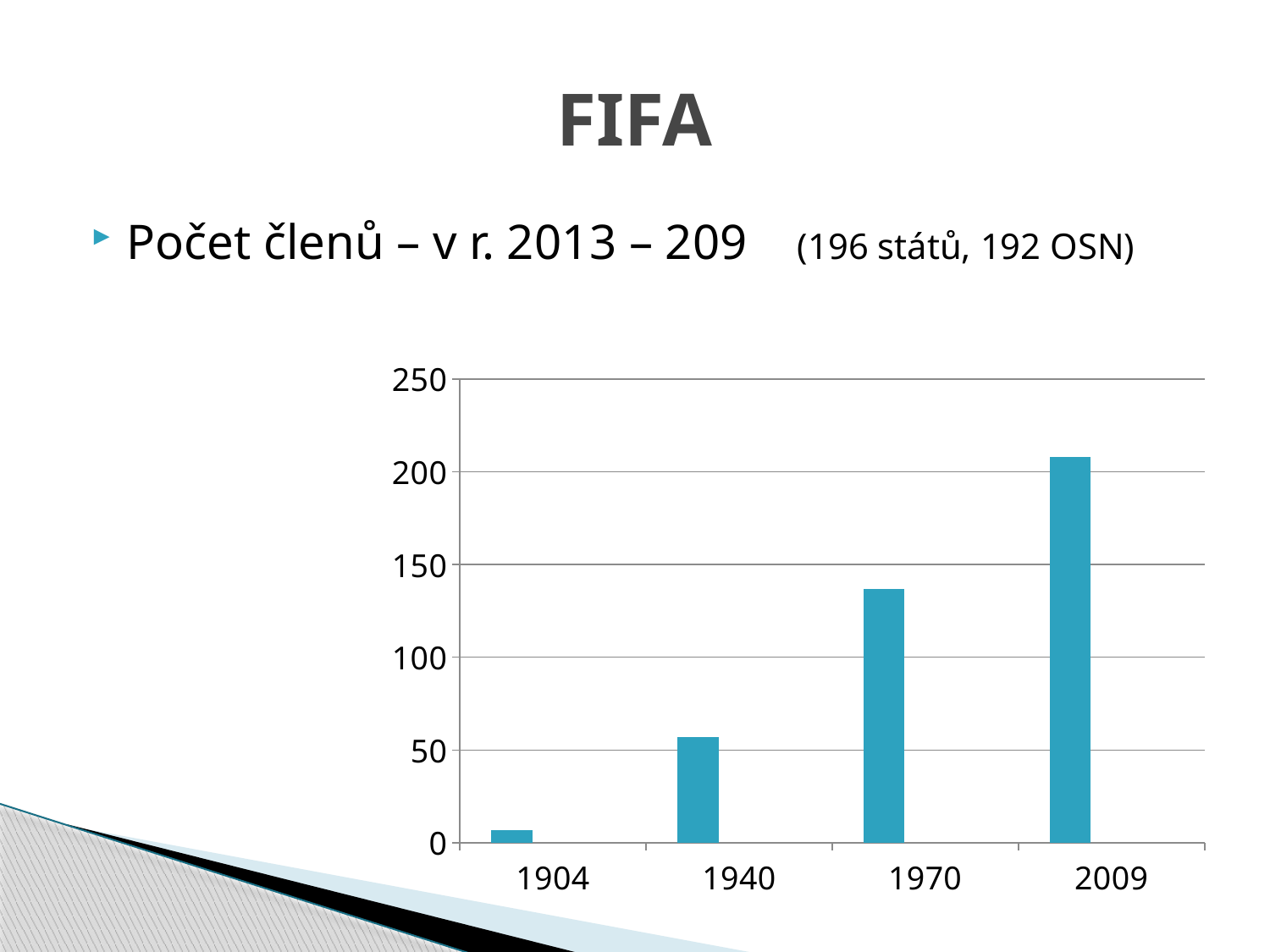
Is the value for 1970 greater or less than 150? less Is the value for 1904 greater or less than 50? less Is the value for 1940 greater or less than 50? greater Which year has the highest bar in the chart? 2009 What is the highest value shown on the vertical axis of the chart? 250 How many categories (years) are shown on the x axis of the chart? 4 What kind of chart is shown on the slide? bar chart Do the values rise or fall from 1904 to 2009 along the x axis? rise Which year has the lowest bar in the chart? 1904 Which is larger, the value for 1940 or the value for 1970? 1970